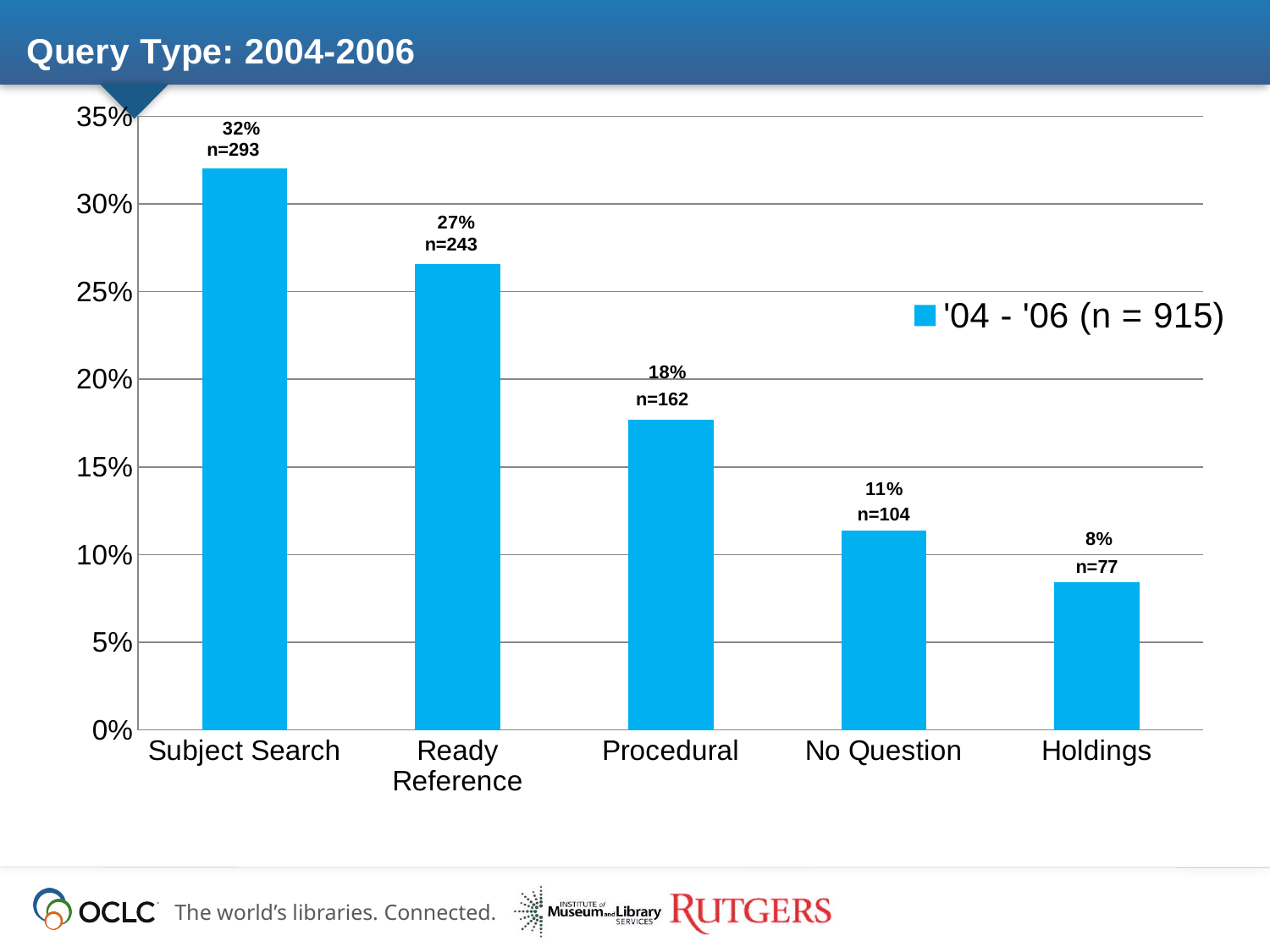
How many query type categories are shown on the x axis? 5 What percentage is shown for Subject Search? 32% Which is larger, the percentage for No Question or the percentage for Holdings? No Question Which query type has the lowest percentage? Holdings How many series does the legend list? 1 What is the legend entry shown on the chart? '04 - '06 (n = 915) What percentage is shown for Procedural? 18% What kind of chart is shown on the slide? Bar chart Which query type has the highest percentage? Subject Search What is the n value shown for Ready Reference? n=243 What is the difference in percentage points between Subject Search and Ready Reference? 5 What is the n value shown for Holdings? n=77